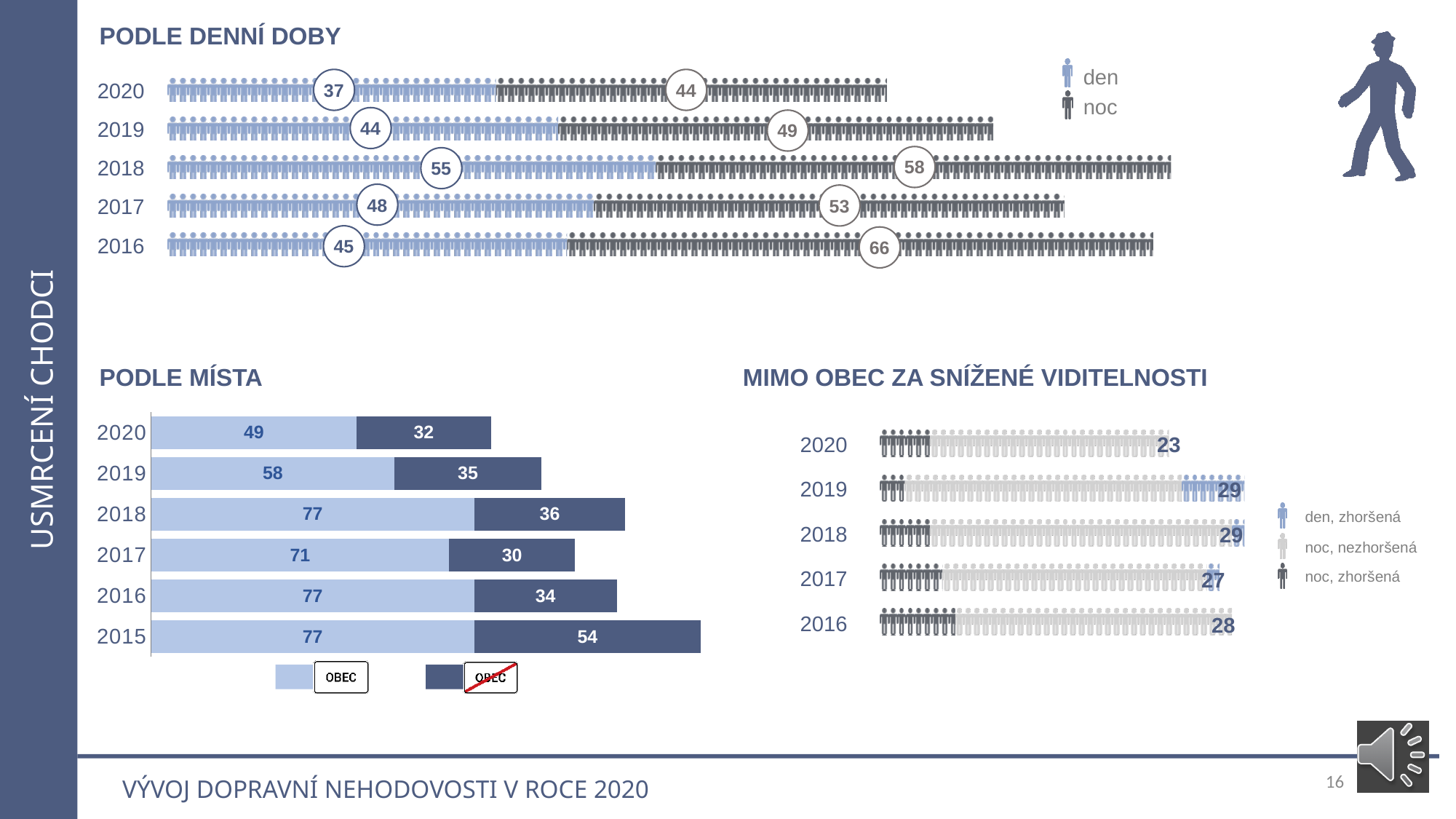
In the PODLE DENNÍ DOBY chart, what is the noc value for 2016? 66 In the PODLE DENNÍ DOBY chart, which year has the highest noc value? 2016 In the PODLE MÍSTA chart, what is the OBEC value for 2019? 58 In the MIMO OBEC ZA SNÍŽENÉ VIDITELNOSTI chart, which year has the lowest value? 2020 In the MIMO OBEC ZA SNÍŽENÉ VIDITELNOSTI chart, what is the value for 2020? 23 In the PODLE MÍSTA chart, what is the total of the stacked bar for 2015? 131 What kind of chart is the PODLE MÍSTA chart? bar chart In the PODLE MÍSTA chart, which year has the lowest value for the dark (mimo OBEC) segment? 2017 In the PODLE DENNÍ DOBY chart, how many series does the legend list? 2 In the PODLE MÍSTA chart, how many years are shown? 6 In the PODLE DENNÍ DOBY chart, what is the difference between the noc and den values for 2018? 3 In the PODLE DENNÍ DOBY chart, what is the den value for 2020? 37